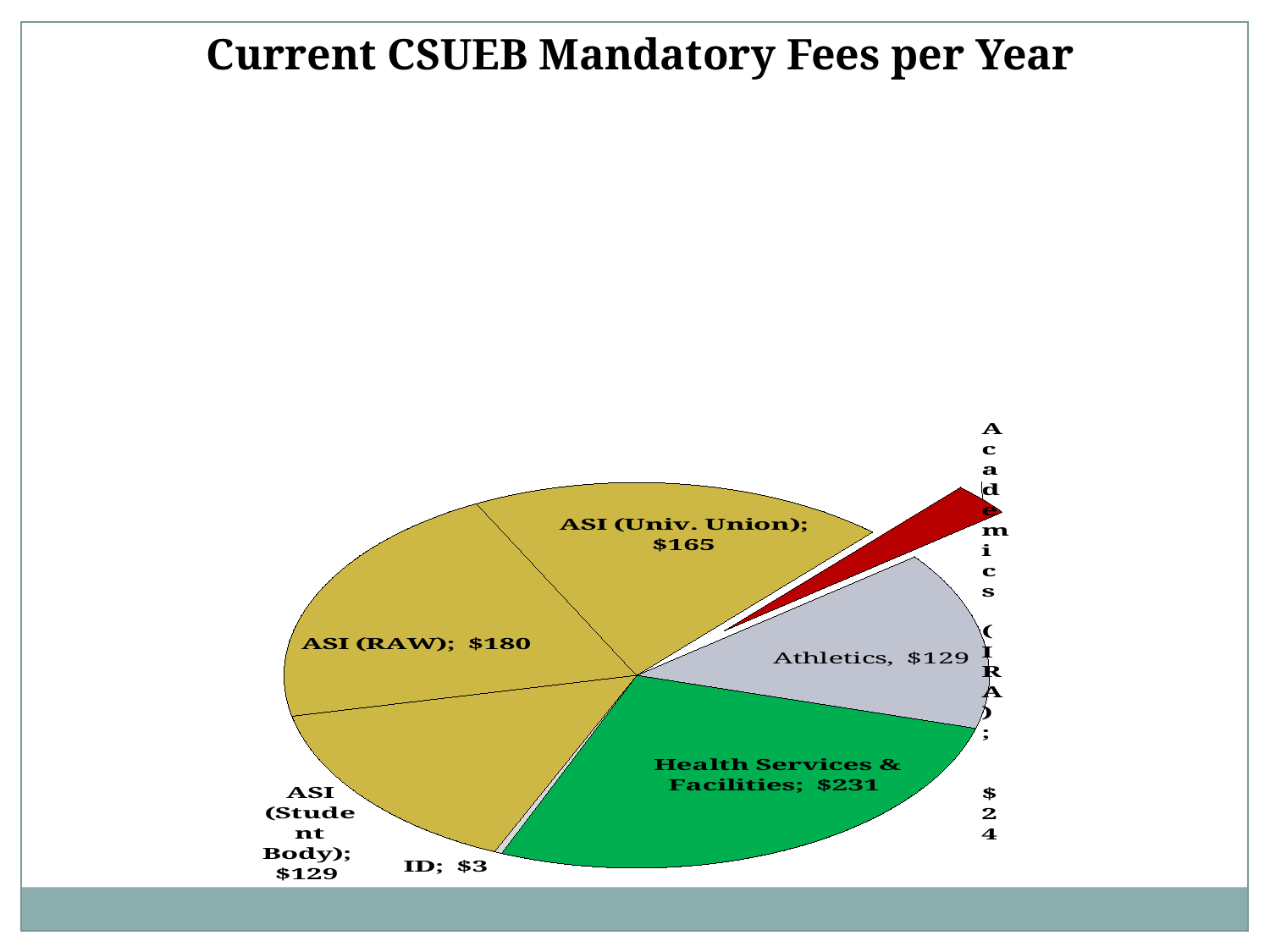
Which is larger, the ASI (RAW) fee or the ASI (Univ. Union) fee? ASI (RAW) What is the fee for ASI (Univ. Union)? $165 Which fee category is the smallest? ID What is the title of the chart? Current CSUEB Mandatory Fees per Year Which fee category is the largest? Health Services & Facilities What is the fee for ASI (RAW)? $180 What kind of chart is shown on the slide? pie chart What is the fee for Health Services & Facilities? $231 What is the fee for Academics (IRA)? $24 How many slices does the pie chart have? 7 What is the difference between the Health Services & Facilities fee and the ASI (RAW) fee? $51 What is the difference between the Athletics fee and the Academics (IRA) fee? $105